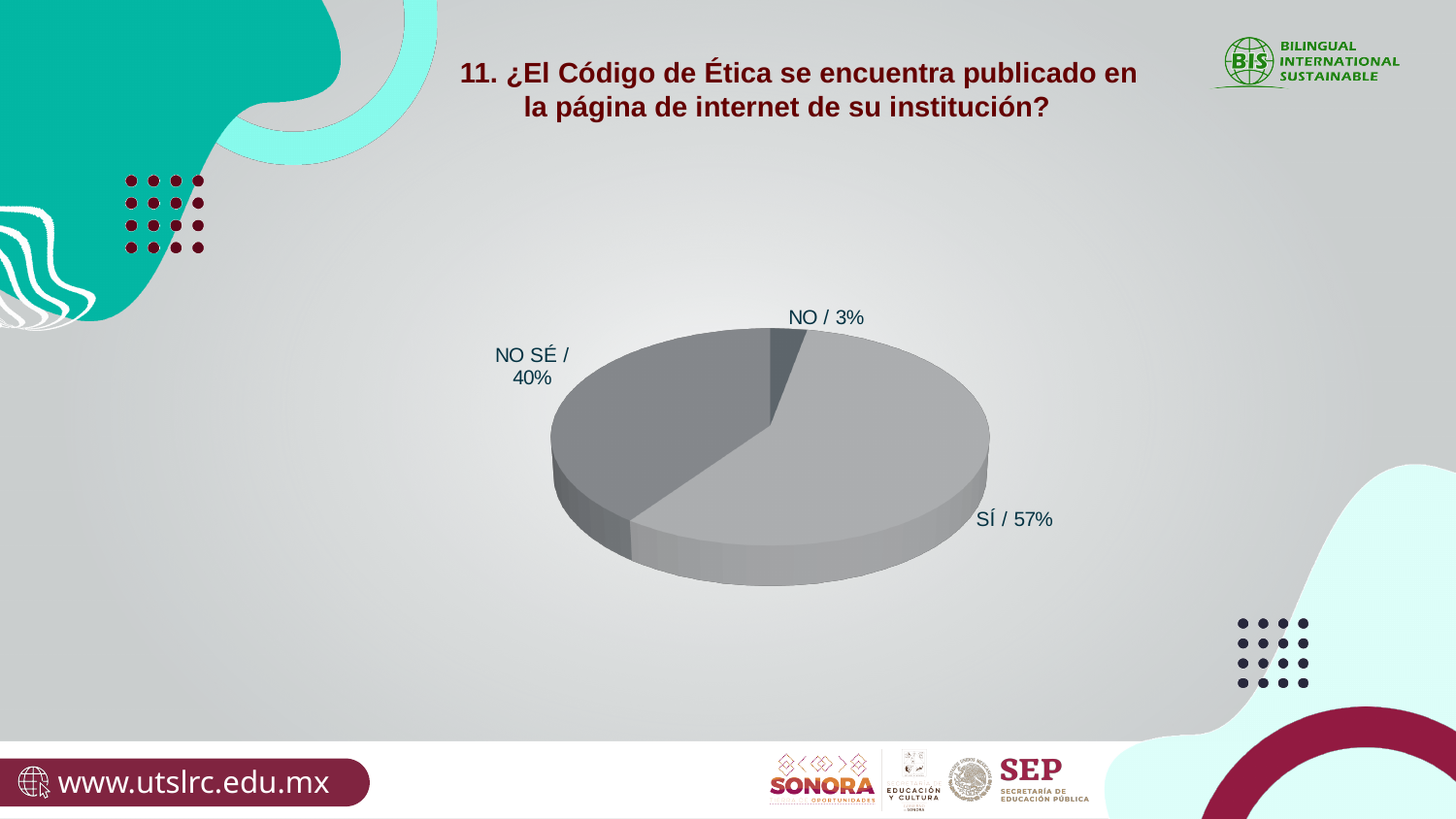
How many slices does the pie chart have? 3 Which response has the largest share of the pie? SÍ What percentage of respondents answered NO SÉ? 40% What percentage of respondents answered NO? 3% What kind of chart is shown on the slide? pie chart Which is larger, the share for NO SÉ or the share for NO? NO SÉ What is the difference in percentage points between the NO SÉ and NO slices? 37 Which response has the smallest share of the pie? NO What question number is shown in the chart title? 11 What is the difference in percentage points between the SÍ and NO SÉ slices? 17 What percentage of respondents answered SÍ? 57% What is the combined share of the SÍ and NO slices? 60%